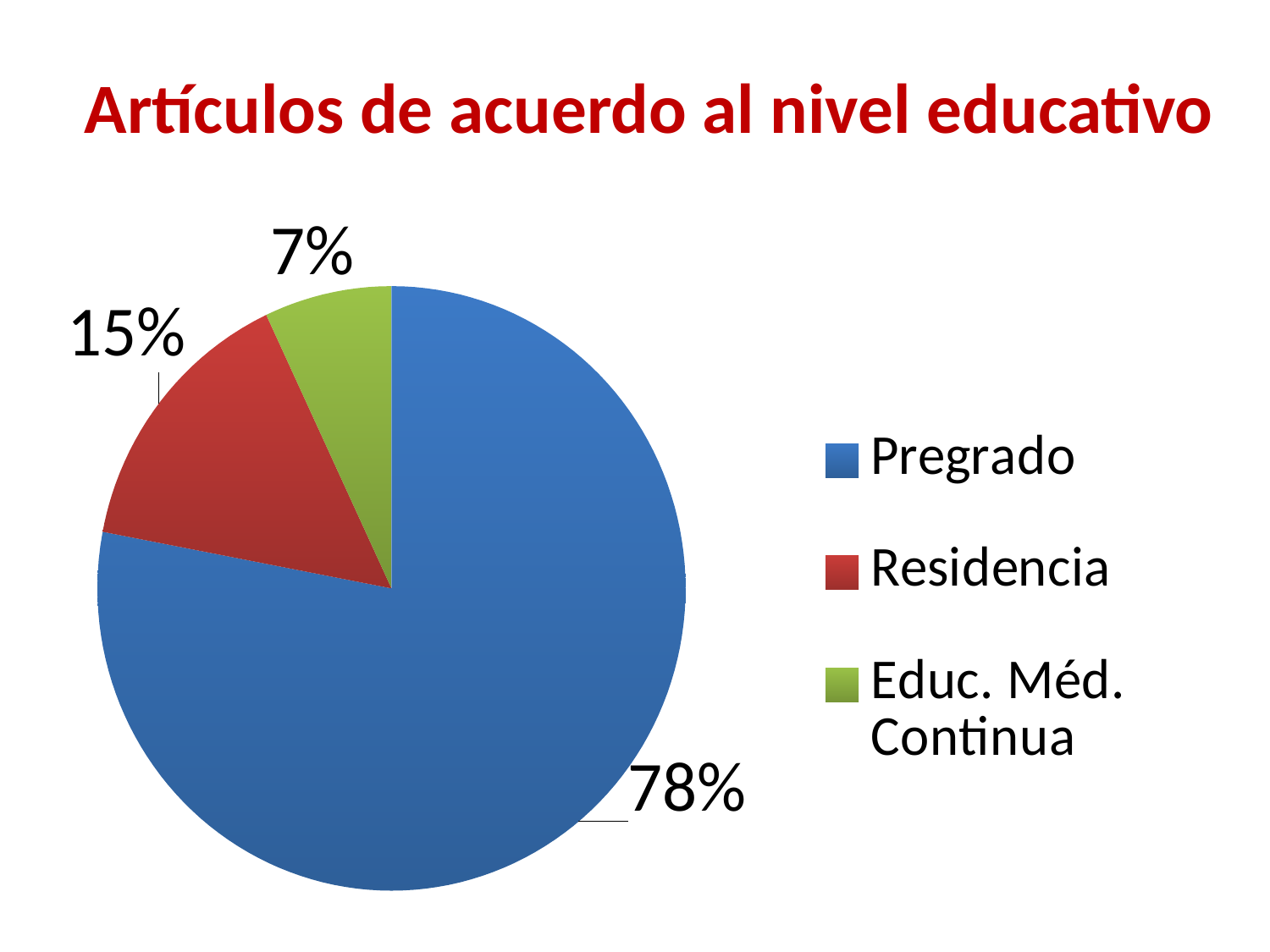
How many categories are shown in the pie chart? 3 What kind of chart is shown on the slide? Pie chart What colour is the slice for Residencia? Red Which is larger, the share for Residencia or the share for Educ. Méd. Continua? Residencia What share of the pie does Pregrado represent? 78% What is the difference in percentage points between Pregrado and Residencia? 63 What share of the pie does Residencia represent? 15% What share of the pie does Educ. Méd. Continua represent? 7% What is the difference in percentage points between Residencia and Educ. Méd. Continua? 8 Which category has the smallest slice of the pie? Educ. Méd. Continua What is the title of the slide? Artículos de acuerdo al nivel educativo Which category has the largest slice of the pie? Pregrado